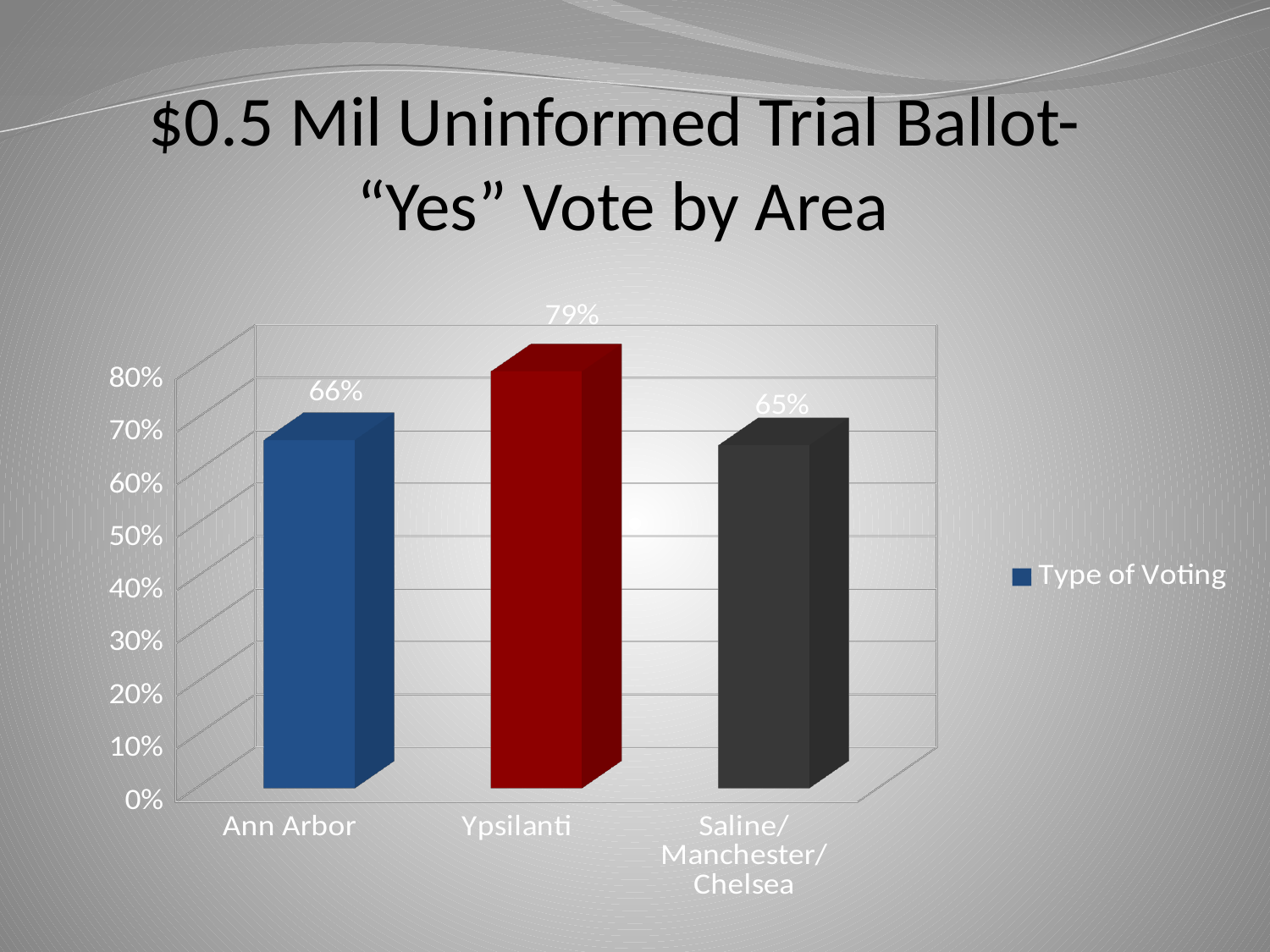
What is the "Yes" vote percentage for Ypsilanti? 79% What kind of chart is shown on the slide? Bar chart What is the legend entry shown on the chart? Type of Voting What is the difference between the "Yes" vote percentages for Ypsilanti and Ann Arbor? 13% What is the "Yes" vote percentage for Ann Arbor? 66% Which area has the highest "Yes" vote percentage? Ypsilanti What is the difference between the "Yes" vote percentages for Ann Arbor and Saline/Manchester/Chelsea? 1% What is the "Yes" vote percentage for Saline/Manchester/Chelsea? 65% Is the value for Ypsilanti greater or less than 70%? greater How many series does the legend list? 1 Which is larger, the "Yes" vote for Ypsilanti or for Saline/Manchester/Chelsea? Ypsilanti How many areas are shown on the chart? 3